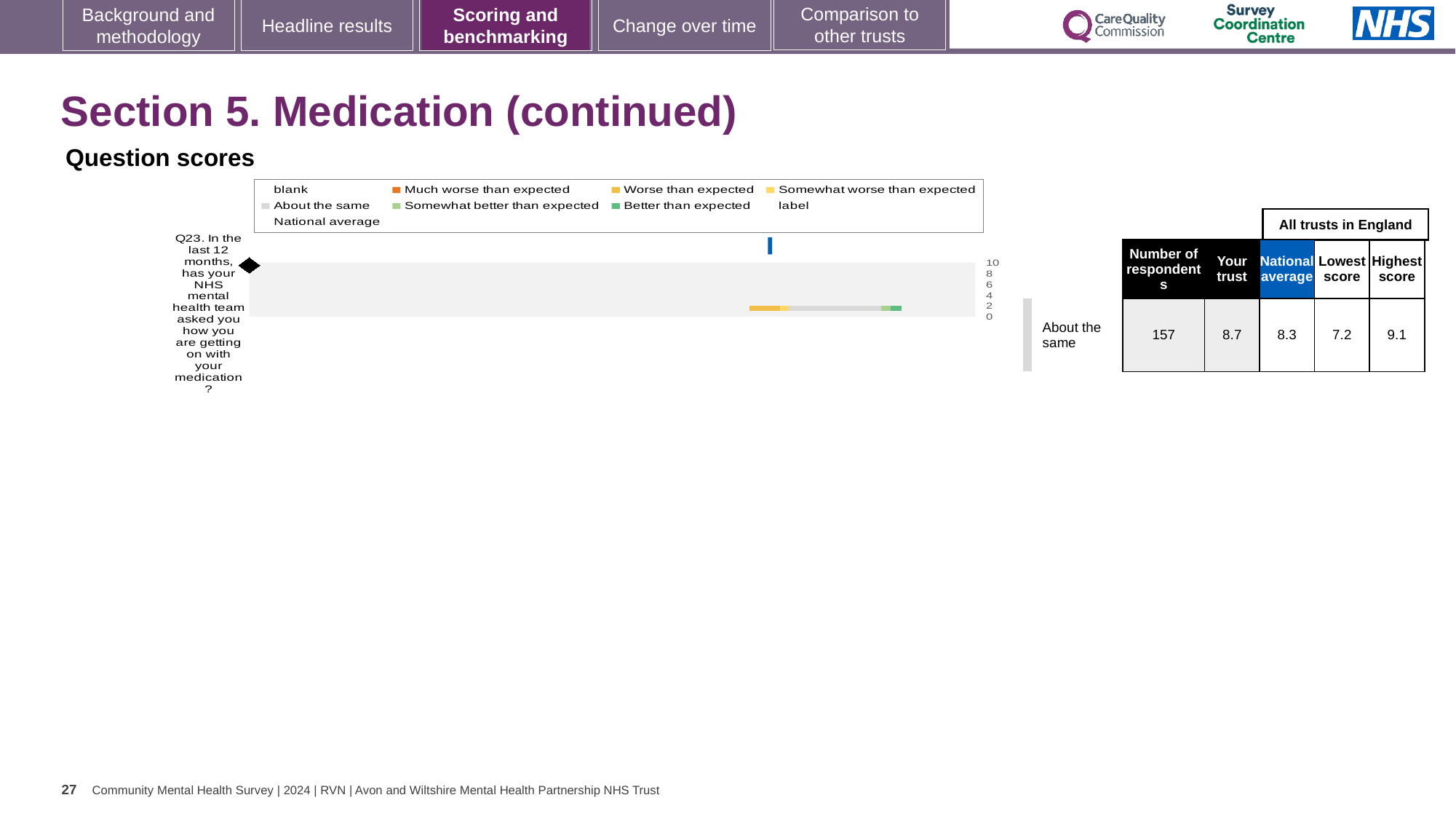
What is the highest value shown on the score axis of the Question scores chart? 10 In the table beside the Question scores chart, what is the "Your trust" score for Q23? 8.7 In the table beside the Question scores chart, what is the national average for Q23? 8.3 Is the national average marker for Q23 in the Question scores chart greater or less than 6? greater Which question is plotted in the Question scores chart? Q23. In the last 12 months, has your NHS mental health team asked you how you are getting on with your medication? According to the table beside the Question scores chart, which is larger for Q23: the "Your trust" score or the national average? Your trust What benchmark category label is shown for Q23 next to the Question scores chart? About the same What kind of chart is shown under "Question scores"? bar chart In the Question scores chart legend, what colour represents "Better than expected"? green In the table beside the Question scores chart, what is the highest score among all trusts in England for Q23? 9.1 How many questions (categories) are plotted in the Question scores chart? 1 In the table beside the Question scores chart, what is the number of respondents for Q23? 157